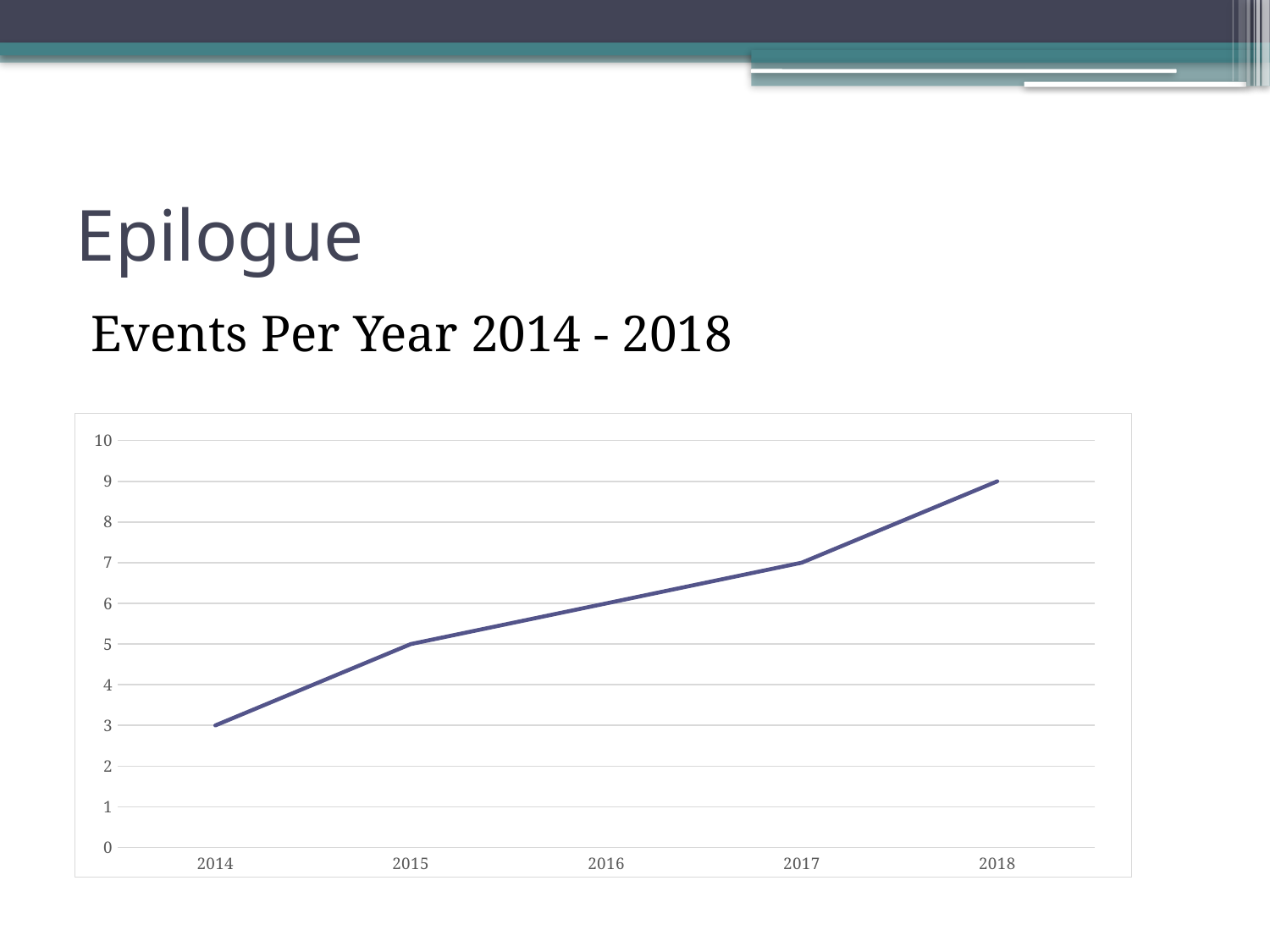
What kind of chart is shown on the slide? line chart What is the value for 2017? 7 What is the value for 2015? 5 What is the value for 2018? 9 Which year has the lowest value? 2014 Do the values rise or fall from 2014 to 2018? rise What is the value for 2014? 3 Which is larger, the value for 2016 or the value for 2015? 2016 What is the difference between the values for 2018 and 2014? 6 Is the value for 2016 greater or less than 5? greater Which year has the highest value? 2018 How many years are plotted on the x axis? 5